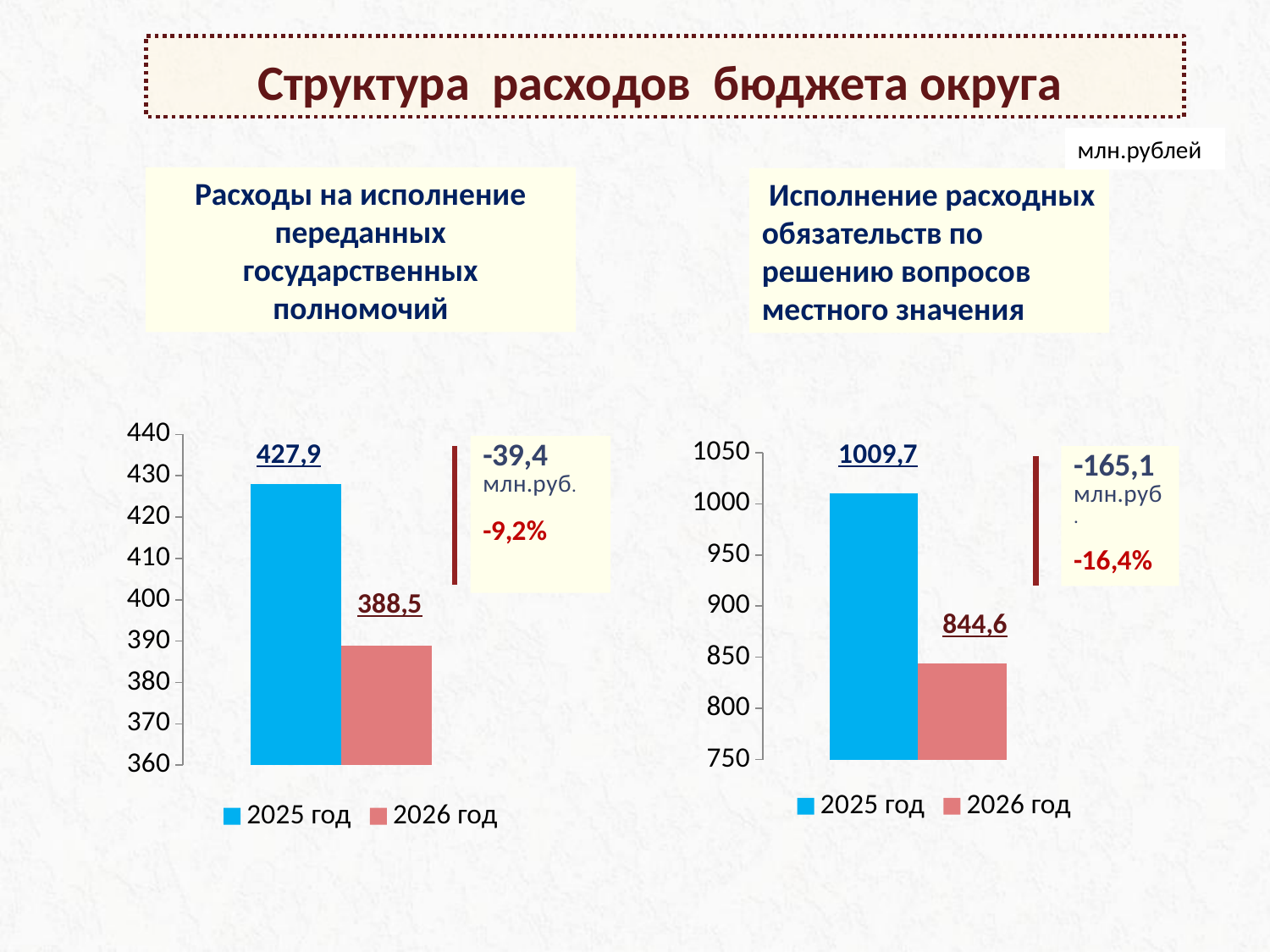
In the right chart (Исполнение расходных обязательств по решению вопросов местного значения), what is the value for 2026 год? 844,6 In the left chart, what is the difference between the 2025 год and 2026 год values? 39,4 In the right chart, is the value for 2026 год greater or less than 850? less In the right chart (Исполнение расходных обязательств по решению вопросов местного значения), what is the value for 2025 год? 1009,7 In the left chart, do the values rise or fall from 2025 год to 2026 год? fall In the right chart, which year has the lower value? 2026 год In the left chart (Расходы на исполнение переданных государственных полномочий), what is the value for 2026 год? 388,5 What kind of chart is the right chart? bar chart In the left chart, which year has the higher value? 2025 год In the left chart (Расходы на исполнение переданных государственных полномочий), what is the value for 2025 год? 427,9 How many series does the legend of the left chart list? 2 In the right chart, what is the difference between the 2025 год and 2026 год values? 165,1